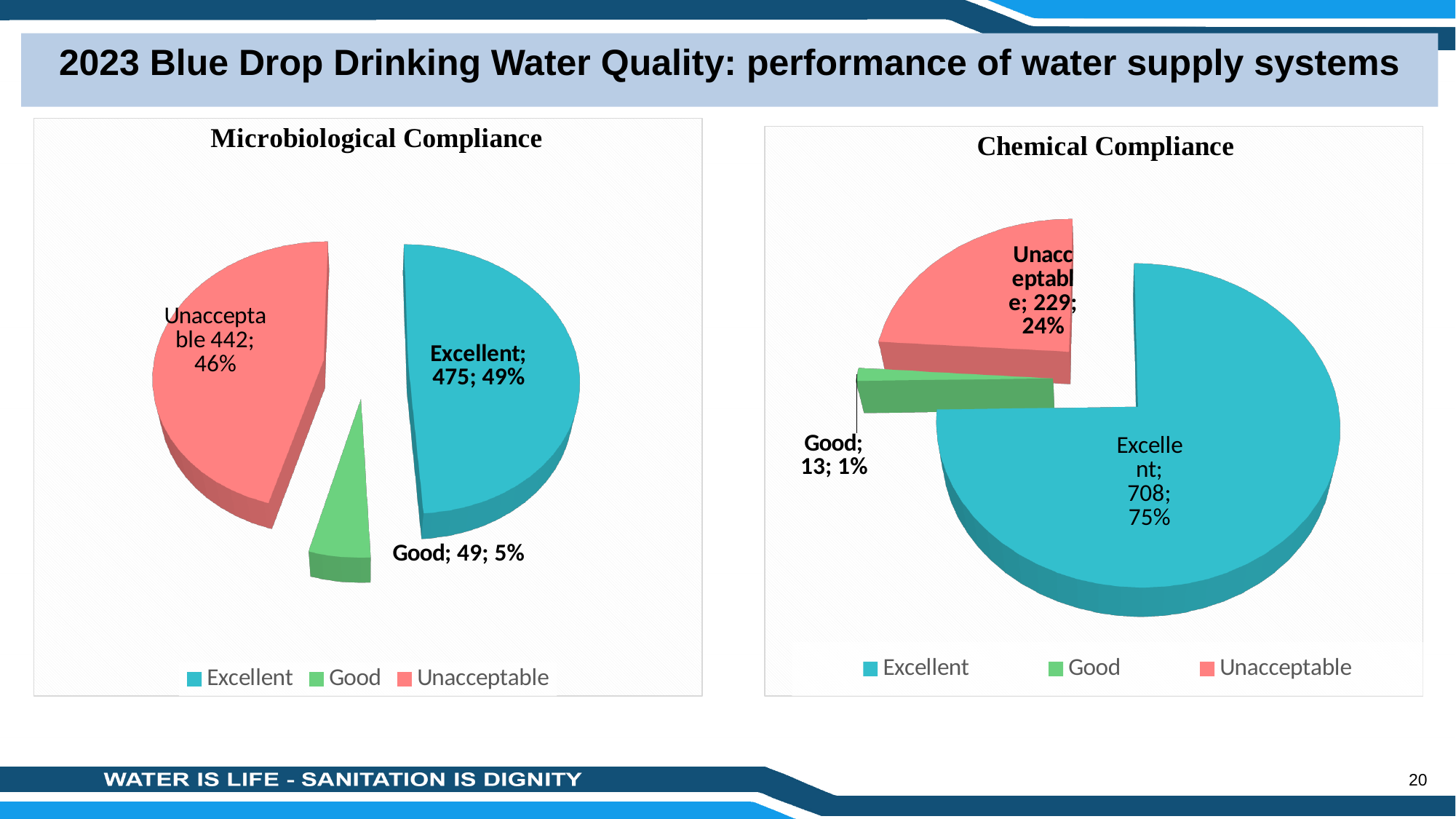
In the Chemical Compliance chart, what share of the pie is Unacceptable? 24% In the Microbiological Compliance chart, which category has the smallest slice? Good In the Chemical Compliance chart, what is the value for Excellent? 708 How many categories does the legend of the Microbiological Compliance chart list? 3 In the Microbiological Compliance chart, what is the value for Good? 49 In the Microbiological Compliance chart, what is the difference between the Excellent and Unacceptable values? 33 What kind of chart is the Chemical Compliance chart? Pie chart In the Chemical Compliance chart, what is the difference between the Excellent and Unacceptable values? 479 In the Microbiological Compliance chart, what is the value for Excellent? 475 In the Chemical Compliance chart, which category has the largest slice? Excellent In the Chemical Compliance chart, what is the value for Good? 13 In the Microbiological Compliance chart, what share of the pie is Unacceptable? 46%